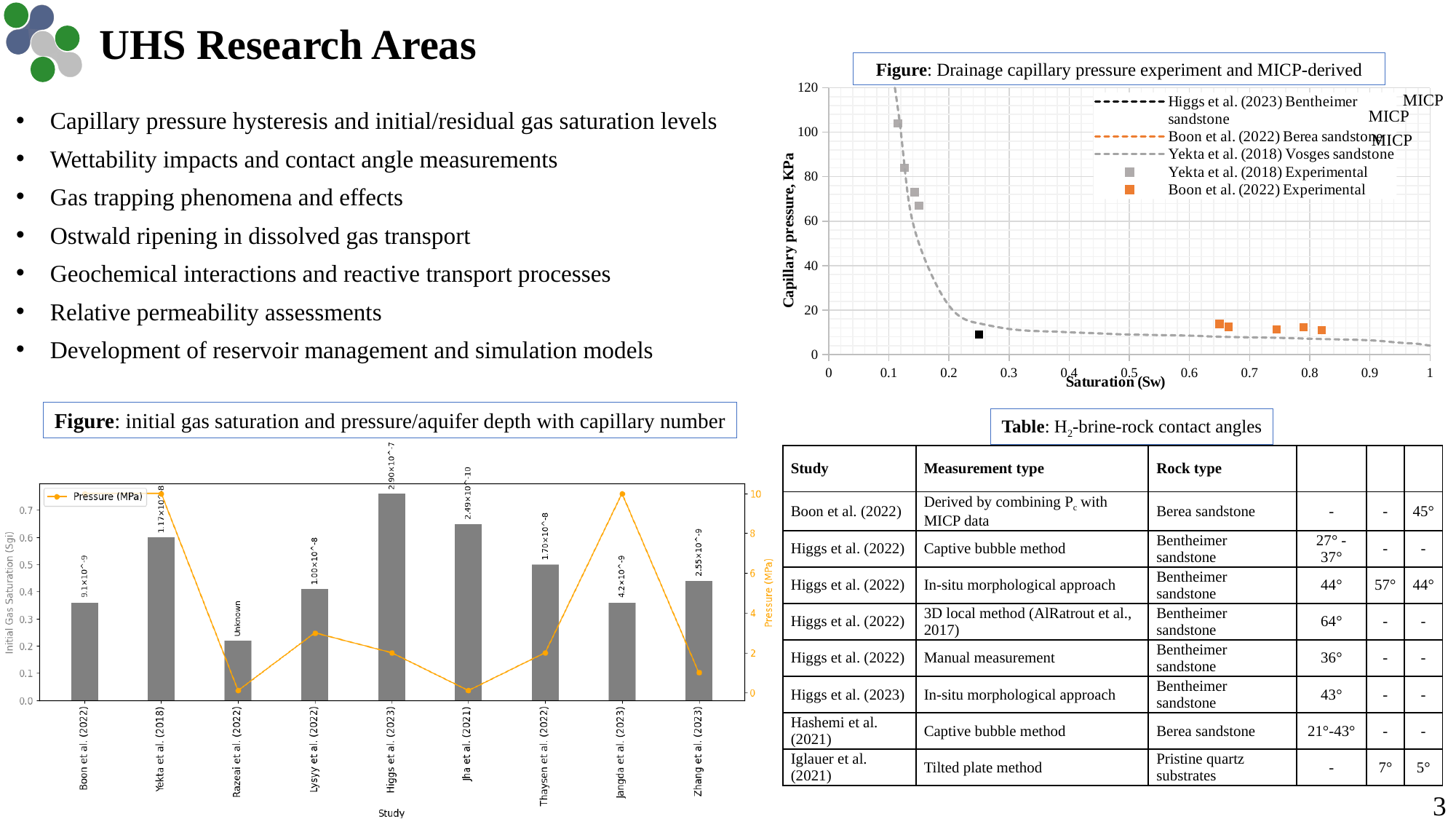
In the top-right drainage capillary pressure chart, what is the y-axis label? Capillary pressure, KPa In the top-right drainage capillary pressure chart, how many entries does the legend list? 5 In the bottom-left bar chart, which study has the highest initial gas saturation bar? Higgs et al. (2023) In the bottom-left bar chart, which has the larger initial gas saturation bar: Jha et al. (2021) or Thaysen et al. (2022)? Jha et al. (2021) In the bottom-left bar chart, which study has the lowest initial gas saturation bar? Razeai et al. (2022) In the bottom-left bar chart, what capillary number is printed above the bar for Higgs et al. (2023)? 2.90×10^-7 In the bottom-left bar chart, what label is printed above the bar for Razeai et al. (2022)? Unknown In the bottom-left bar chart, is the initial gas saturation for Boon et al. (2022) greater or less than 0.4? less What kind of chart is the bottom-left figure (initial gas saturation and pressure/aquifer depth with capillary number)? bar chart In the top-right drainage capillary pressure chart, are the Boon et al. (2022) Experimental points greater or less than 20 KPa? less In the bottom-left bar chart, is the initial gas saturation for Yekta et al. (2018) greater or less than 0.5? greater In the bottom-left bar chart, how many studies are shown on the x axis? 9